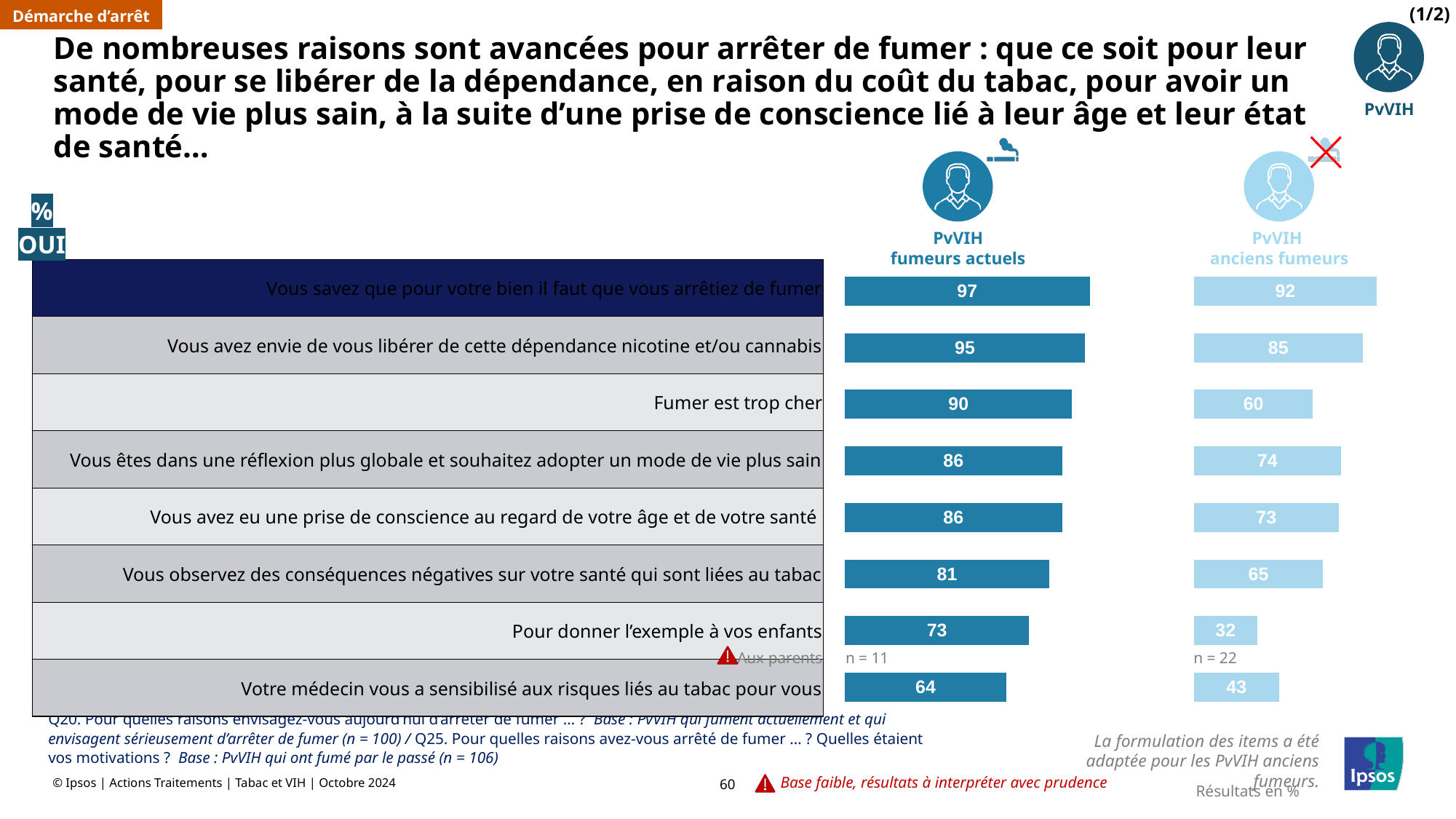
In the 'PvVIH anciens fumeurs' chart, what is the value for 'Vous avez envie de vous libérer de cette dépendance nicotine et/ou cannabis'? 85 In the 'PvVIH fumeurs actuels' chart, which reason has the highest value? Vous savez que pour votre bien il faut que vous arrêtiez de fumer In the 'PvVIH fumeurs actuels' chart, what is the value for 'Vous avez eu une prise de conscience au regard de votre âge et de votre santé'? 86 In the 'PvVIH fumeurs actuels' chart, what is the value for 'Fumer est trop cher'? 90 In the 'PvVIH anciens fumeurs' chart, what is the value for 'Pour donner l'exemple à vos enfants'? 32 In the 'PvVIH fumeurs actuels' chart, which reason has the lowest value? Votre médecin vous a sensibilisé aux risques liés au tabac pour vous What is the difference between the 'PvVIH fumeurs actuels' and 'PvVIH anciens fumeurs' values for 'Pour donner l'exemple à vos enfants'? 41 What kind of chart is used to show the 'PvVIH anciens fumeurs' results? Bar chart How many reasons (categories) are listed in the 'PvVIH fumeurs actuels' chart? 8 In the 'PvVIH anciens fumeurs' chart, which reason has the lowest value? Pour donner l'exemple à vos enfants What is the difference between the 'PvVIH fumeurs actuels' and 'PvVIH anciens fumeurs' values for 'Fumer est trop cher'? 30 For 'Vous observez des conséquences négatives sur votre santé qui sont liées au tabac', which group has the larger value: 'PvVIH fumeurs actuels' or 'PvVIH anciens fumeurs'? PvVIH fumeurs actuels